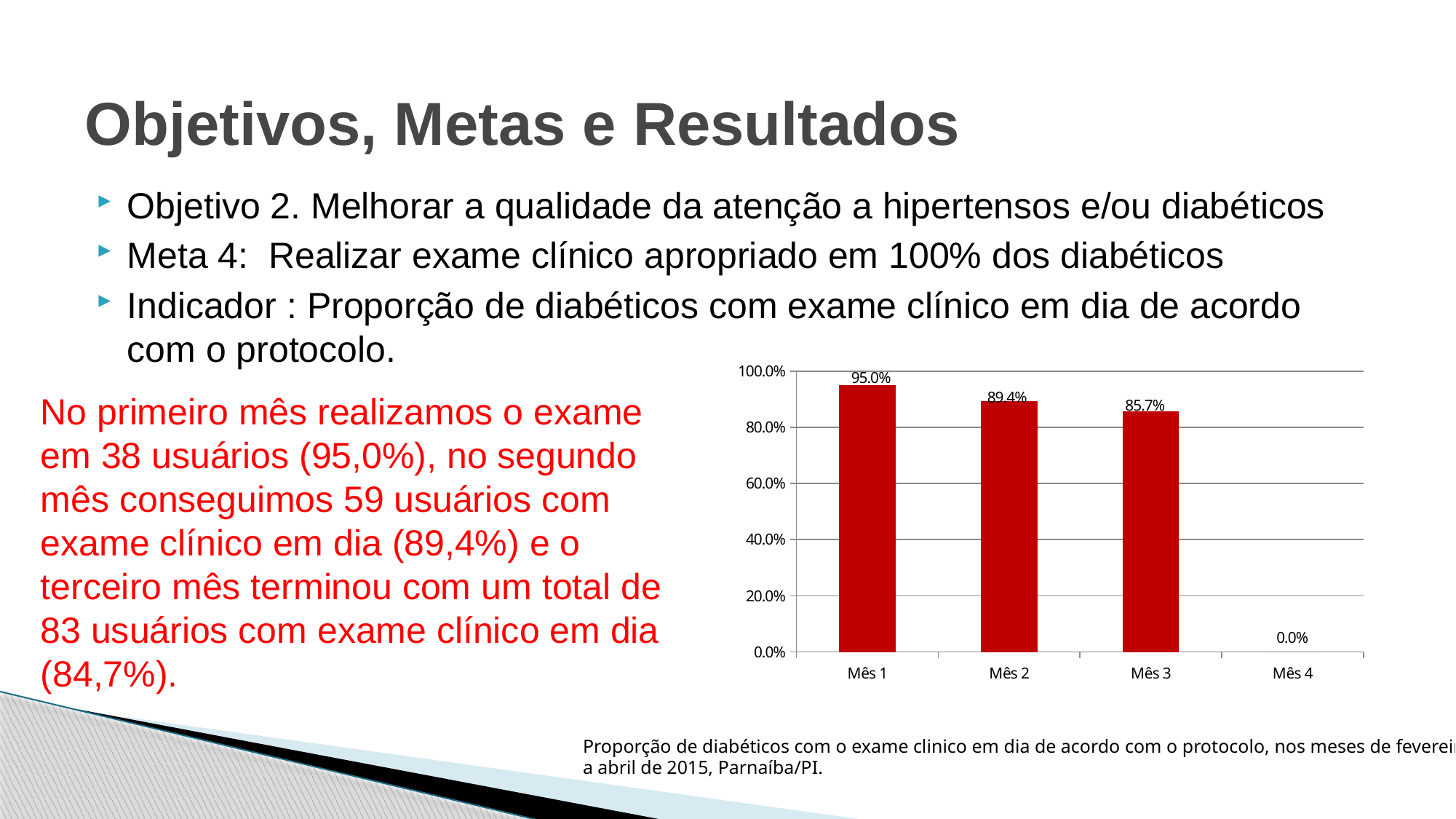
What is the value shown for Mês 3? 85.7% What is the value shown for Mês 4? 0.0% What is the difference between the values for Mês 2 and Mês 3? 3.7% Which month has the highest value in the chart? Mês 1 Which is larger, the value for Mês 2 or the value for Mês 3? Mês 2 What is the value shown for Mês 2? 89.4% What is the value shown for Mês 1? 95.0% What is the difference between the values for Mês 1 and Mês 2? 5.6% How many month categories are shown on the x axis of the chart? 4 Which month has the lowest value in the chart? Mês 4 What type of chart is shown on the slide? Bar chart Do the values rise or fall from Mês 1 to Mês 3? Fall